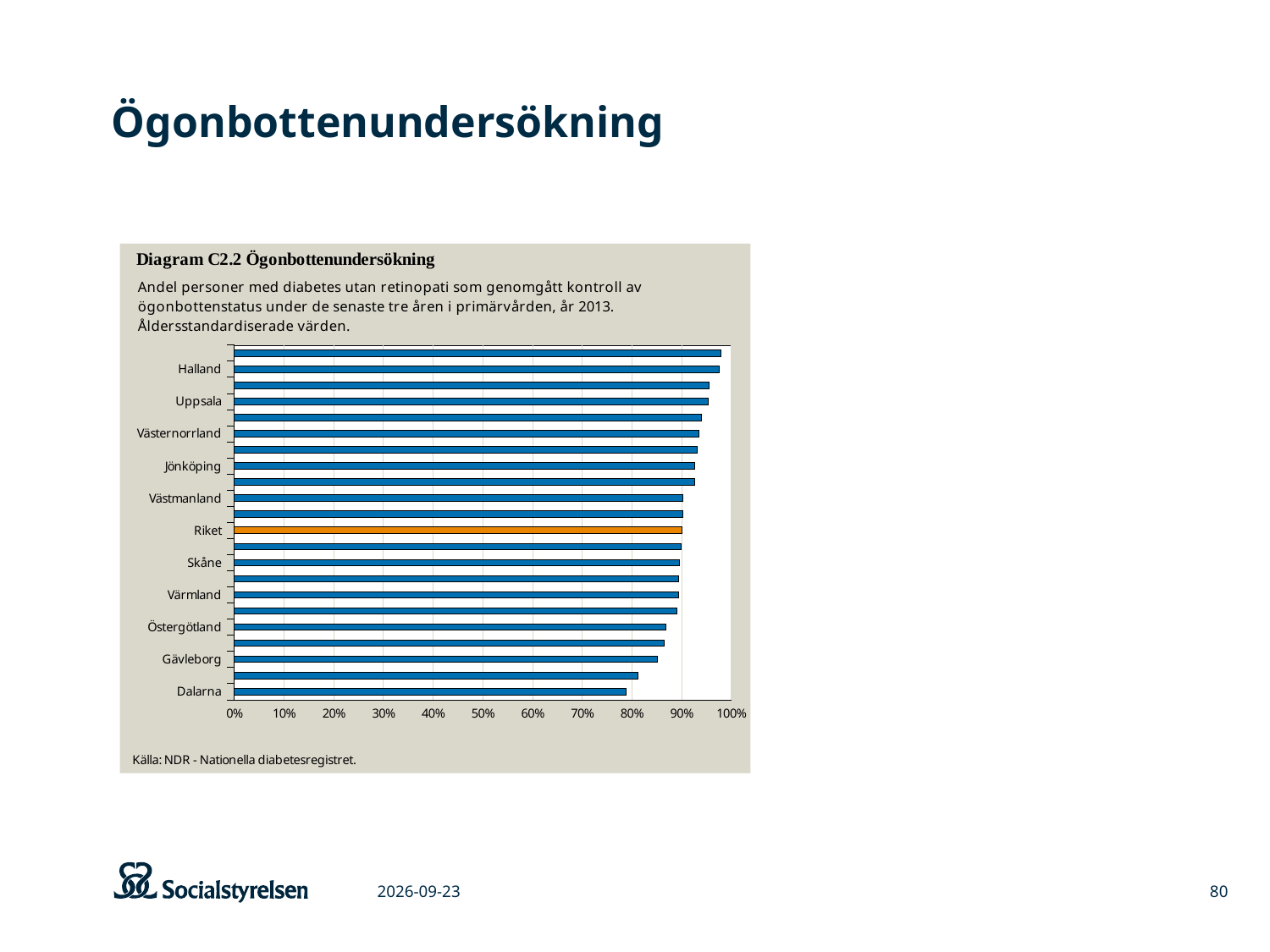
What is the title of the diagram? Diagram C2.2 Ögonbottenundersökning Which of the labelled categories has the lowest value? Dalarna Is the value for Uppsala greater or less than 90%? greater Which has the larger value, Uppsala or Gävleborg? Uppsala Is the value for Dalarna greater or less than 80%? less Is the value for Östergötland greater or less than 90%? less Which bar is drawn in orange rather than blue? Riket What kind of chart is shown on the slide? bar chart Which has the larger value, Halland or Dalarna? Halland